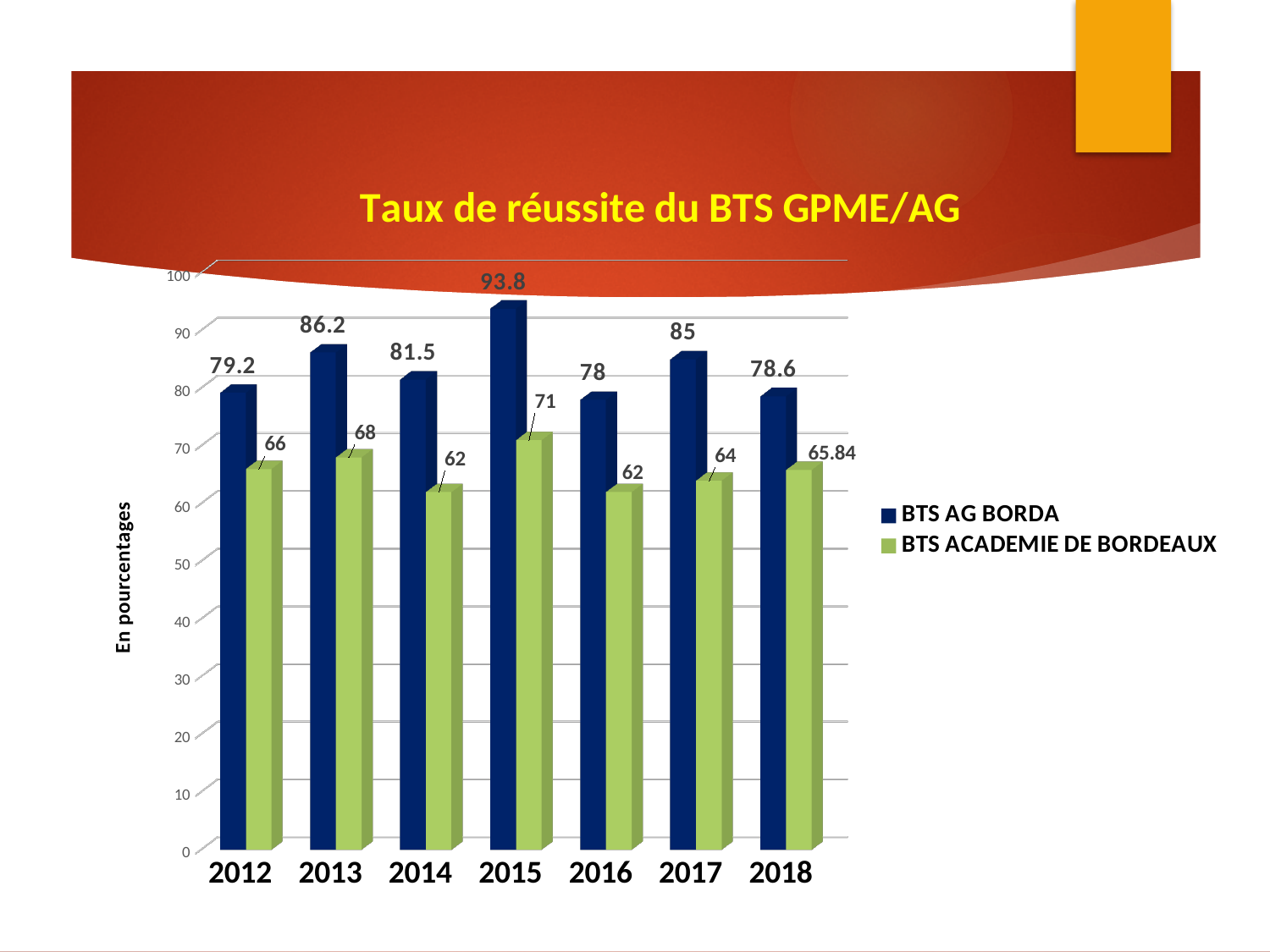
What is the value for BTS AG BORDA in 2013? 86.2 Which is larger in 2017: BTS AG BORDA or BTS ACADEMIE DE BORDEAUX? BTS AG BORDA How many years are shown on the x axis? 7 What is the title of the chart? Taux de réussite du BTS GPME/AG How many series does the legend list? 2 In which year is the BTS AG BORDA value highest? 2015 In which year is the BTS ACADEMIE DE BORDEAUX value highest? 2015 What is the difference between BTS AG BORDA and BTS ACADEMIE DE BORDEAUX in 2015? 22.8 What kind of chart is shown on the slide? Bar chart In which year is the BTS AG BORDA value lowest? 2016 What is the value for BTS ACADEMIE DE BORDEAUX in 2018? 65.84 What is the value for BTS AG BORDA in 2015? 93.8